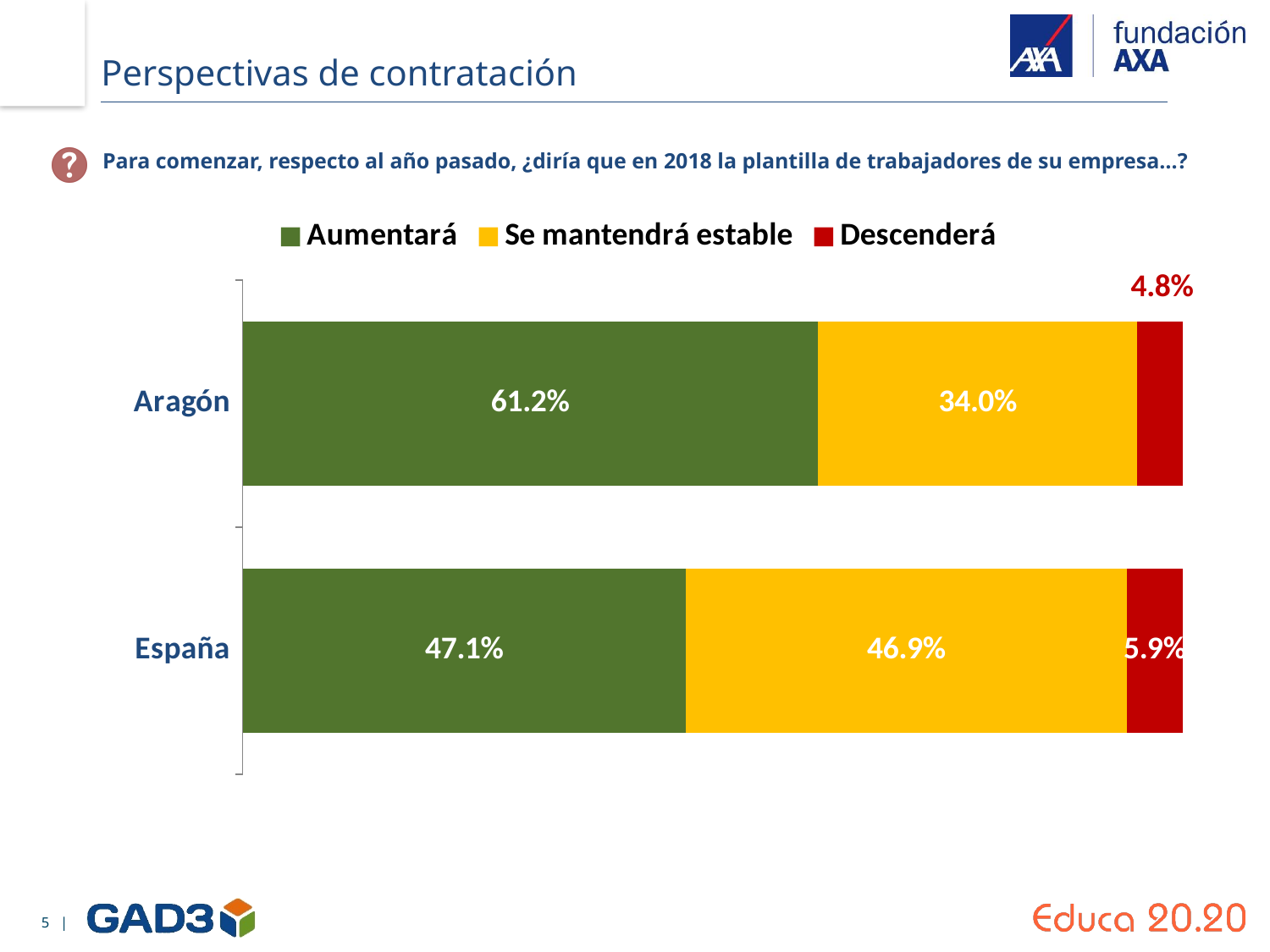
How many series does the legend list? 3 What kind of chart is shown on the slide? Stacked bar chart Which category has the lower value for "Descenderá", Aragón or España? Aragón What is the difference between the "Aumentará" values for Aragón and España? 14.1% How many categories are shown on the chart? 2 What is the total of the stacked bar for Aragón? 100.0% What is the value for "Se mantendrá estable" for España? 46.9% Which category has the higher value for "Aumentará", Aragón or España? Aragón What is the difference between the "Se mantendrá estable" values for España and Aragón? 12.9% What is the value for "Aumentará" for Aragón? 61.2% What is the value for "Descenderá" for Aragón? 4.8% What is the value for "Aumentará" for España? 47.1%